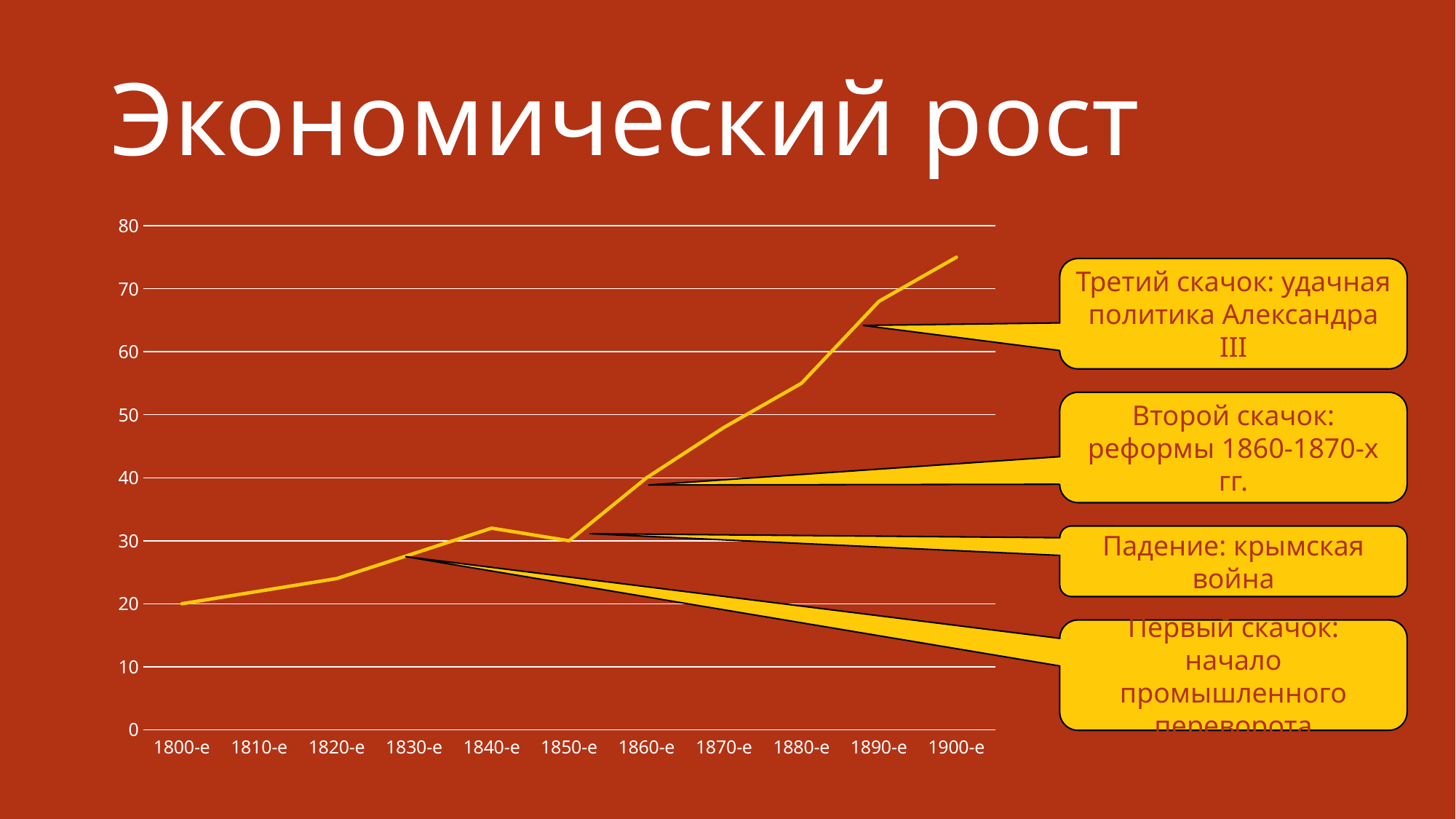
Which decade has the lowest value on the chart? 1800-е How many decades are plotted along the x axis of the chart? 11 Is the value for 1830-е greater or less than 30? less What is the value for 1800-е? 20 What is the title of the slide containing the chart? Экономический рост Is the value for 1880-е greater or less than 50? greater Which is larger, the value for 1880-е or the value for 1890-е? 1890-е Do the values generally rise or fall from 1800-е to 1900-е? rise Which decade has the highest value on the chart? 1900-е What kind of chart is shown on the slide? line chart Is the value for 1900-е greater or less than 70? greater